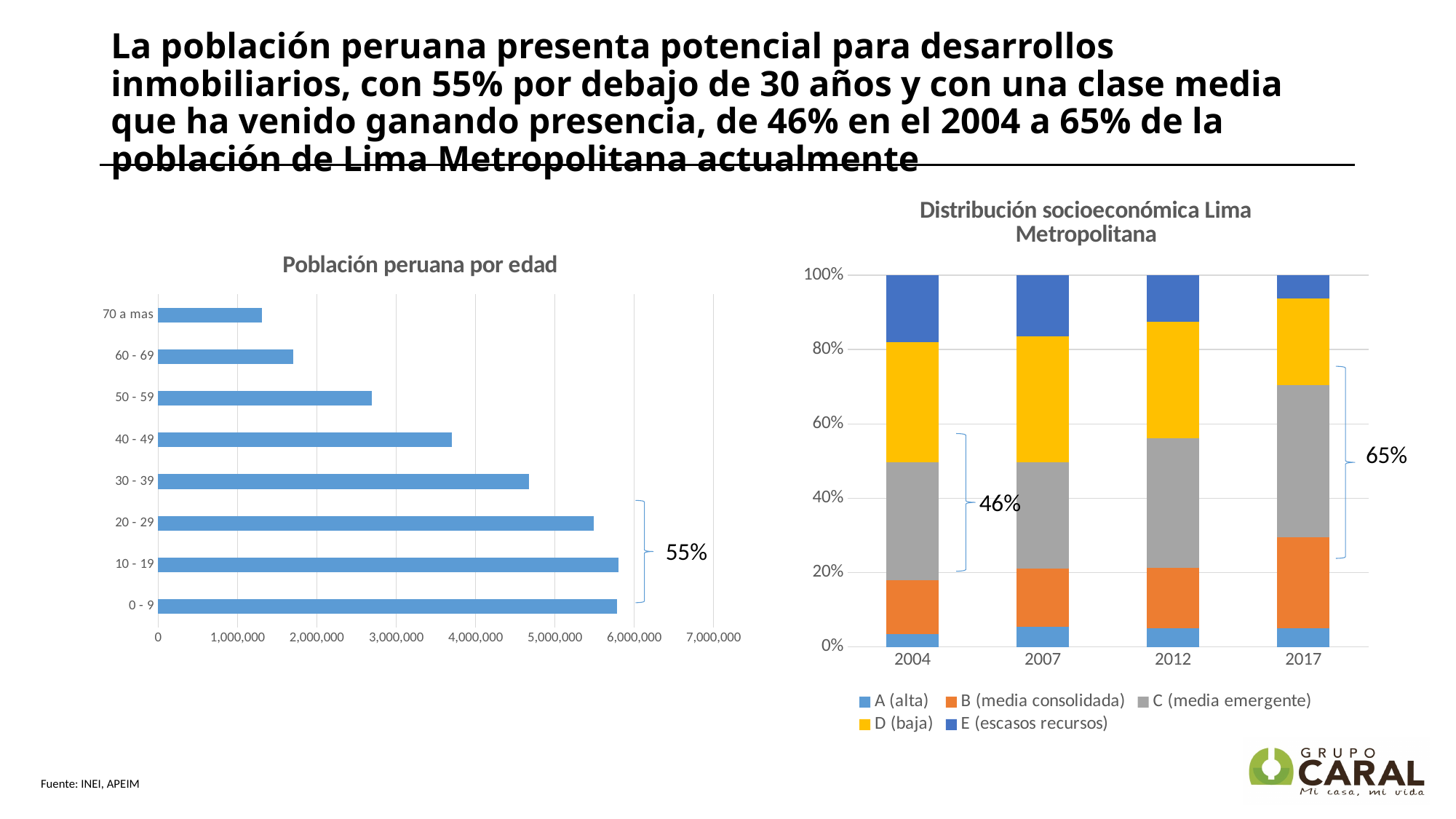
In the 'Población peruana por edad' chart, is the value for '40 - 49' greater or less than 3,000,000? greater How many age categories are shown in the 'Población peruana por edad' chart? 8 In the 'Población peruana por edad' chart, what percentage is annotated for the combined 0 - 9, 10 - 19 and 20 - 29 groups? 55% In the 'Población peruana por edad' chart, is the value for '20 - 29' greater or less than 5,000,000? greater In the 'Población peruana por edad' chart, which is larger: the population for '40 - 49' or for '50 - 59'? 40 - 49 In the 'Población peruana por edad' chart, is the value for '70 a mas' greater or less than 2,000,000? less How many years are shown on the x axis of the 'Distribución socioeconómica Lima Metropolitana' chart? 4 How many series does the legend of the 'Distribución socioeconómica Lima Metropolitana' chart list? 5 What type of chart is 'Población peruana por edad'? bar chart In the 'Distribución socioeconómica Lima Metropolitana' chart, which year has the smaller 'E (escasos recursos)' segment: 2004 or 2017? 2017 In the 'Población peruana por edad' chart, which age group has the lowest population? 70 a mas In the 'Distribución socioeconómica Lima Metropolitana' chart, what percentage is annotated for the middle-class segments in 2017? 65%